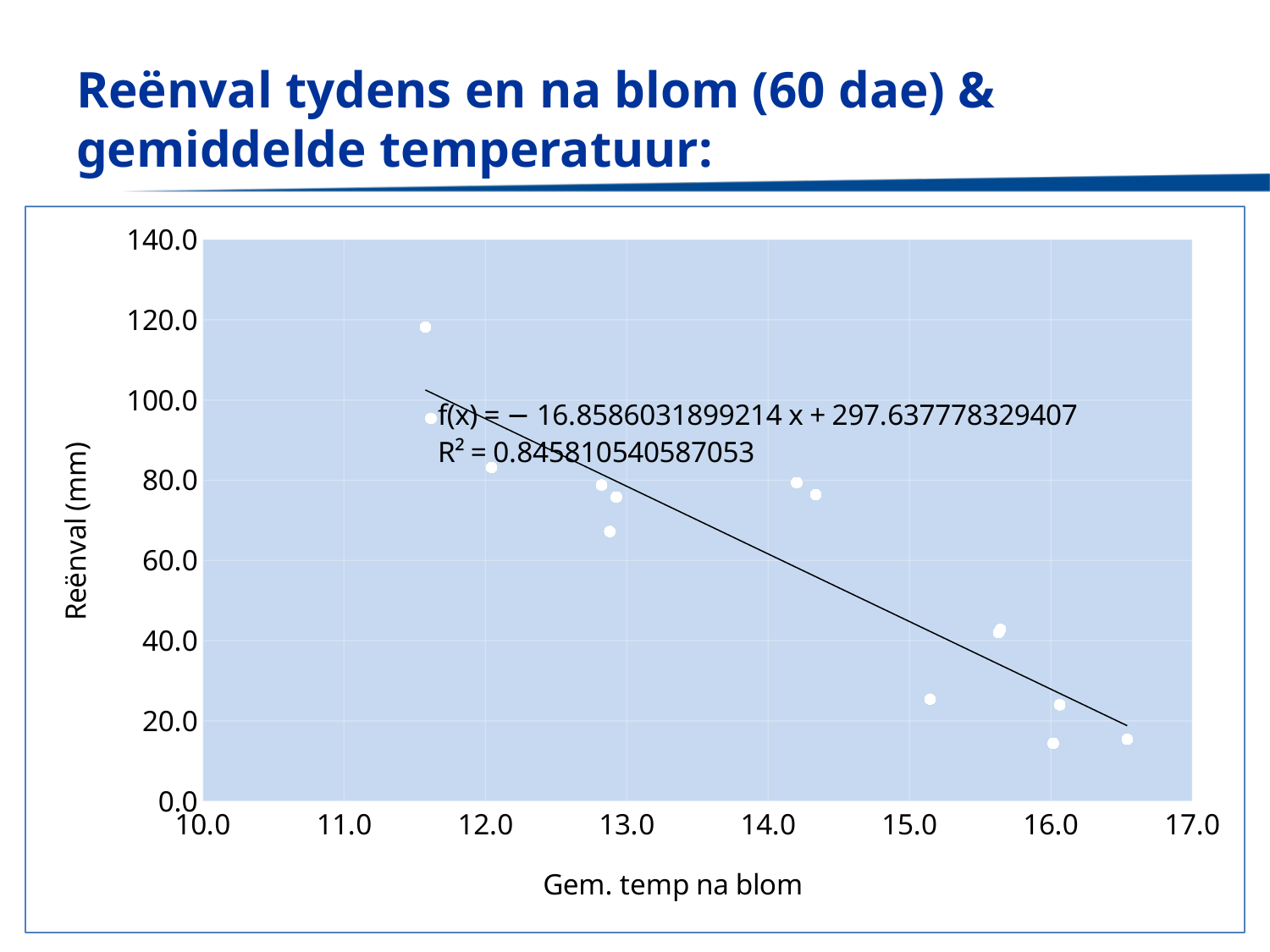
Is the rainfall value for the point at the highest temperature (around 16.5) greater or less than 20.0? less What is the label of the y axis? Reënval (mm) Which has the higher rainfall: the point near 11.6 on the x axis or the point near 16.5 on the x axis? the point near 11.6 What is the maximum value shown on the y axis? 140.0 What R² value is printed on the chart for the trendline? 0.845810540587053 Do the rainfall values generally rise or fall as the average temperature after bloom increases? fall What is the label of the x axis? Gem. temp na blom What is the intercept of the trendline equation printed on the chart? 297.637778329407 Is the highest plotted rainfall value greater or less than 100.0? greater What kind of chart is shown on the slide? scatter chart Is the rainfall value for the point near 15.0 on the x axis greater or less than 40.0? less What is the slope of the trendline equation printed on the chart? − 16.8586031899214